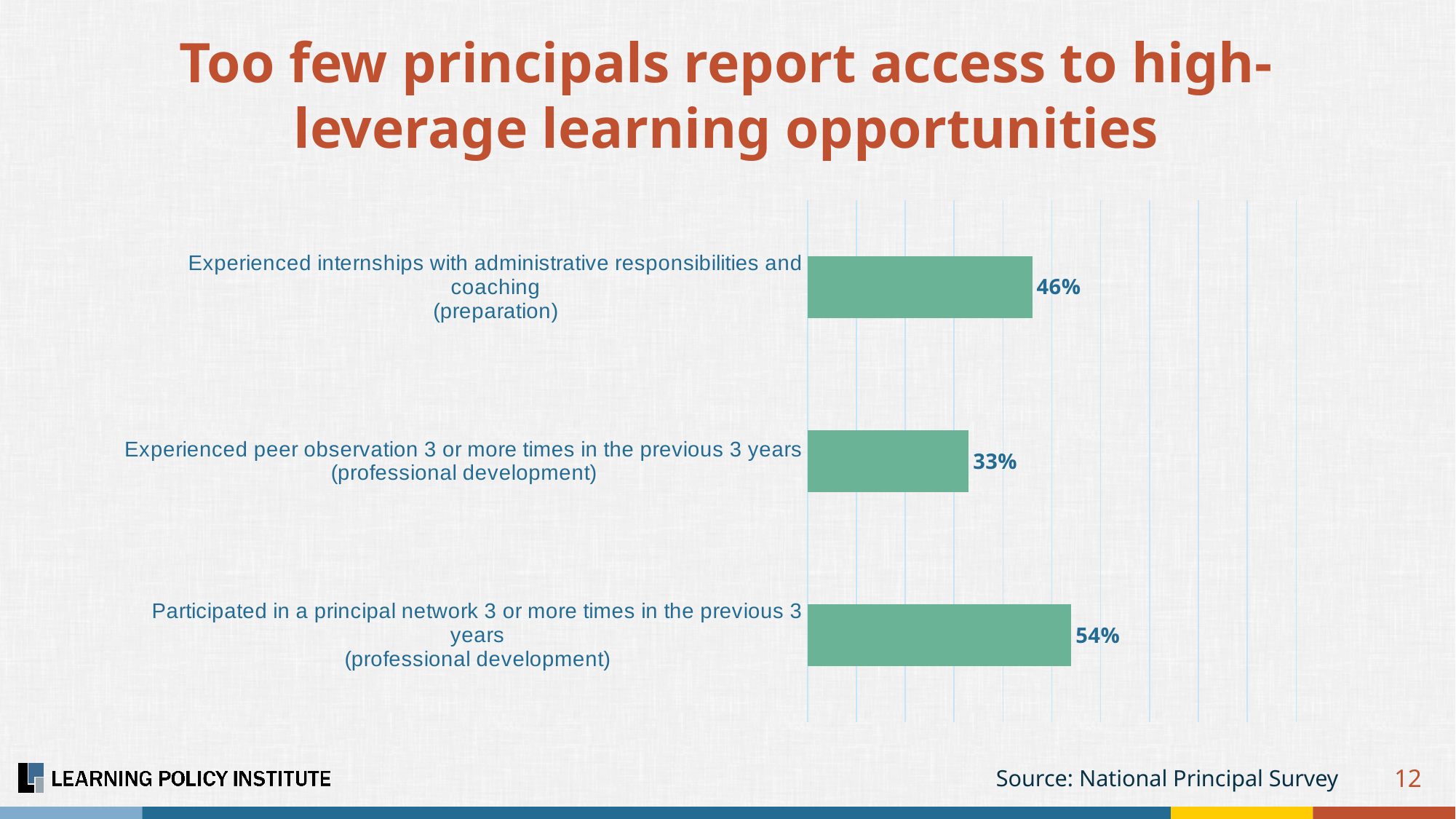
Which category has the lowest value? Experienced peer observation 3 or more times in the previous 3 years (professional development) What percentage of principals experienced internships with administrative responsibilities and coaching (preparation)? 46% What is the difference between the value for experiencing internships with administrative responsibilities and coaching and the value for experiencing peer observation? 13% What is the source cited for the chart? National Principal Survey Which category has the highest value? Participated in a principal network 3 or more times in the previous 3 years (professional development) What percentage of principals experienced peer observation 3 or more times in the previous 3 years? 33% Which is larger: the value for experiencing internships with administrative responsibilities and coaching or the value for participating in a principal network? Participated in a principal network 3 or more times in the previous 3 years How many categories are shown in the chart? 3 What percentage of principals participated in a principal network 3 or more times in the previous 3 years? 54% What colour are the bars in the chart? Green What is the difference between the value for participating in a principal network and the value for experiencing peer observation? 21% What kind of chart is shown on the slide? Bar chart